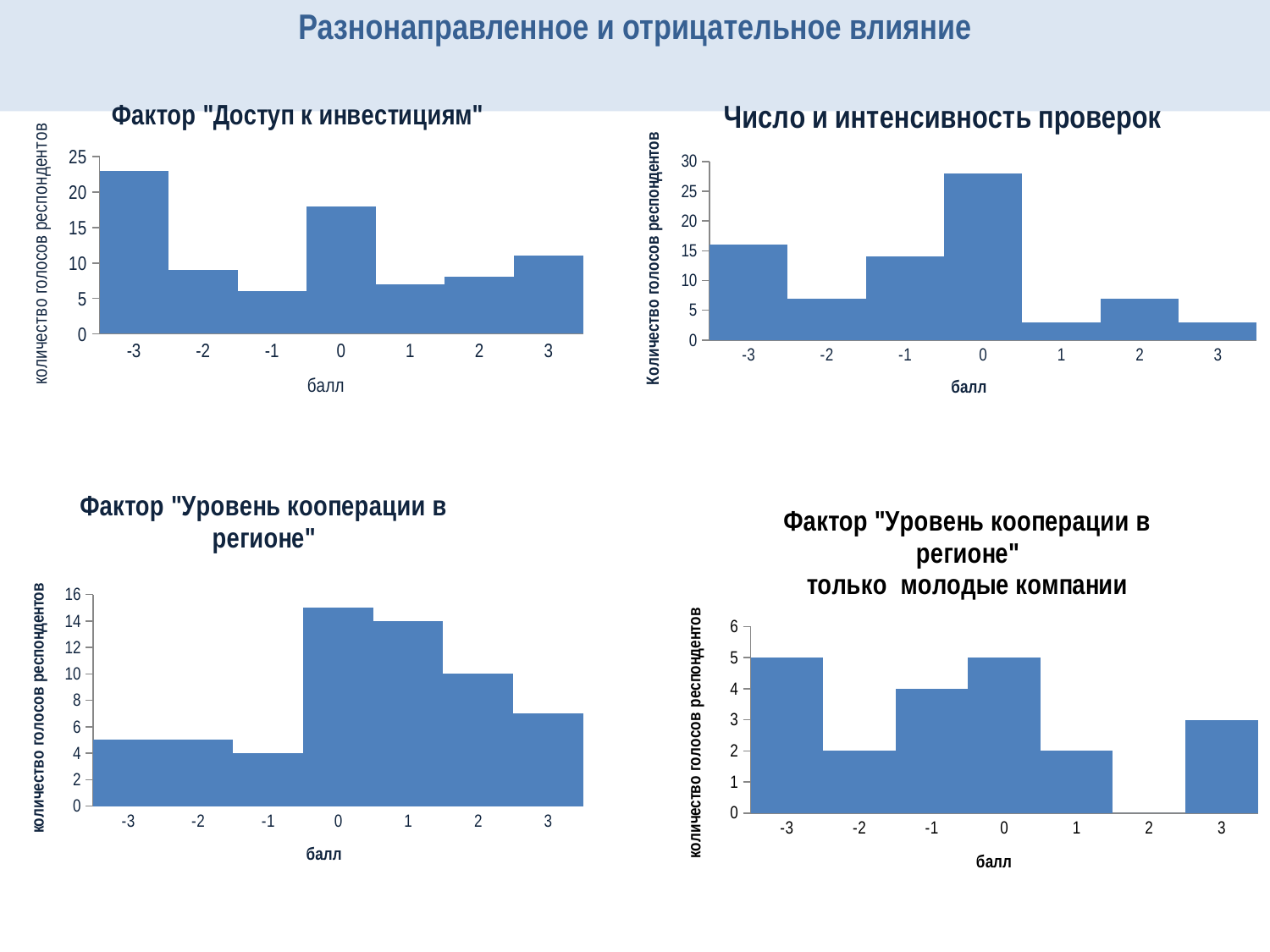
What kind of chart is the "Фактор "Доступ к инвестициям"" chart? bar chart In the "Фактор "Уровень кооперации в регионе" только молодые компании" chart, what is the value for балл -1? 4 In the "Фактор "Доступ к инвестициям"" chart, which балл has the highest number of votes? -3 In the "Фактор "Уровень кооперации в регионе"" chart (bottom left), what is the value for балл 2? 10 In the "Число и интенсивность проверок" chart, which балл has the highest number of votes? 0 How many балл categories are shown in the "Фактор "Доступ к инвестициям"" chart? 7 In the "Фактор "Уровень кооперации в регионе" только молодые компании" chart, what is the difference between the values for балл -3 and балл -2? 3 In the "Число и интенсивность проверок" chart, which is larger: the value for балл -3 or the value for балл -2? -3 In the "Фактор "Уровень кооперации в регионе"" chart (bottom left), what is the value for балл 1? 14 In the "Число и интенсивность проверок" chart, is the value for балл 1 greater or less than 5? less In the "Фактор "Уровень кооперации в регионе" только молодые компании" chart, which балл has the lowest number of votes? 2 In the "Фактор "Доступ к инвестициям"" chart, is the value for балл 0 greater or less than 15? greater